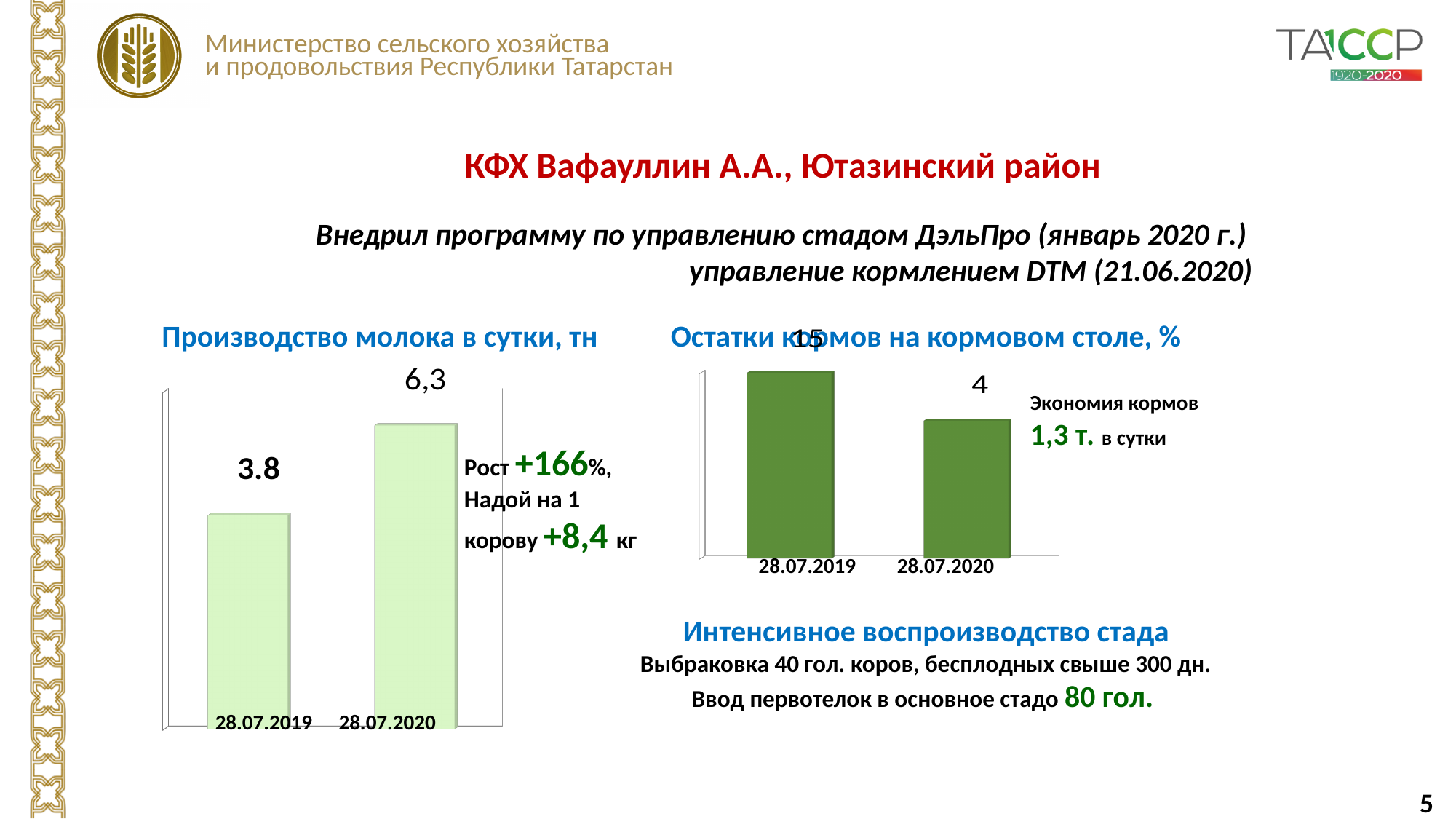
In the chart 'Остатки кормов на кормовом столе, %', what is the value for 28.07.2020? 4 In the chart 'Остатки кормов на кормовом столе, %', which date has the lowest value? 28.07.2020 In the chart 'Производство молока в сутки, тн', what is the value for 28.07.2019? 3.8 In the chart 'Производство молока в сутки, тн', what is the value for 28.07.2020? 6,3 In the chart 'Производство молока в сутки, тн', by how much does the value for 28.07.2020 exceed the value for 28.07.2019? 2,5 In the chart 'Остатки кормов на кормовом столе, %', is the value for 28.07.2019 larger or smaller than the value for 28.07.2020? larger In the chart 'Производство молока в сутки, тн', which date has the higher value? 28.07.2020 What type of chart is 'Остатки кормов на кормовом столе, %'? bar chart How many bars are shown in the chart 'Производство молока в сутки, тн'? 2 In the chart 'Остатки кормов на кормовом столе, %', what is the value for 28.07.2019? 15 In the chart 'Остатки кормов на кормовом столе, %', do the values rise or fall from 28.07.2019 to 28.07.2020? fall In the chart 'Остатки кормов на кормовом столе, %', what is the difference between the values for 28.07.2019 and 28.07.2020? 11